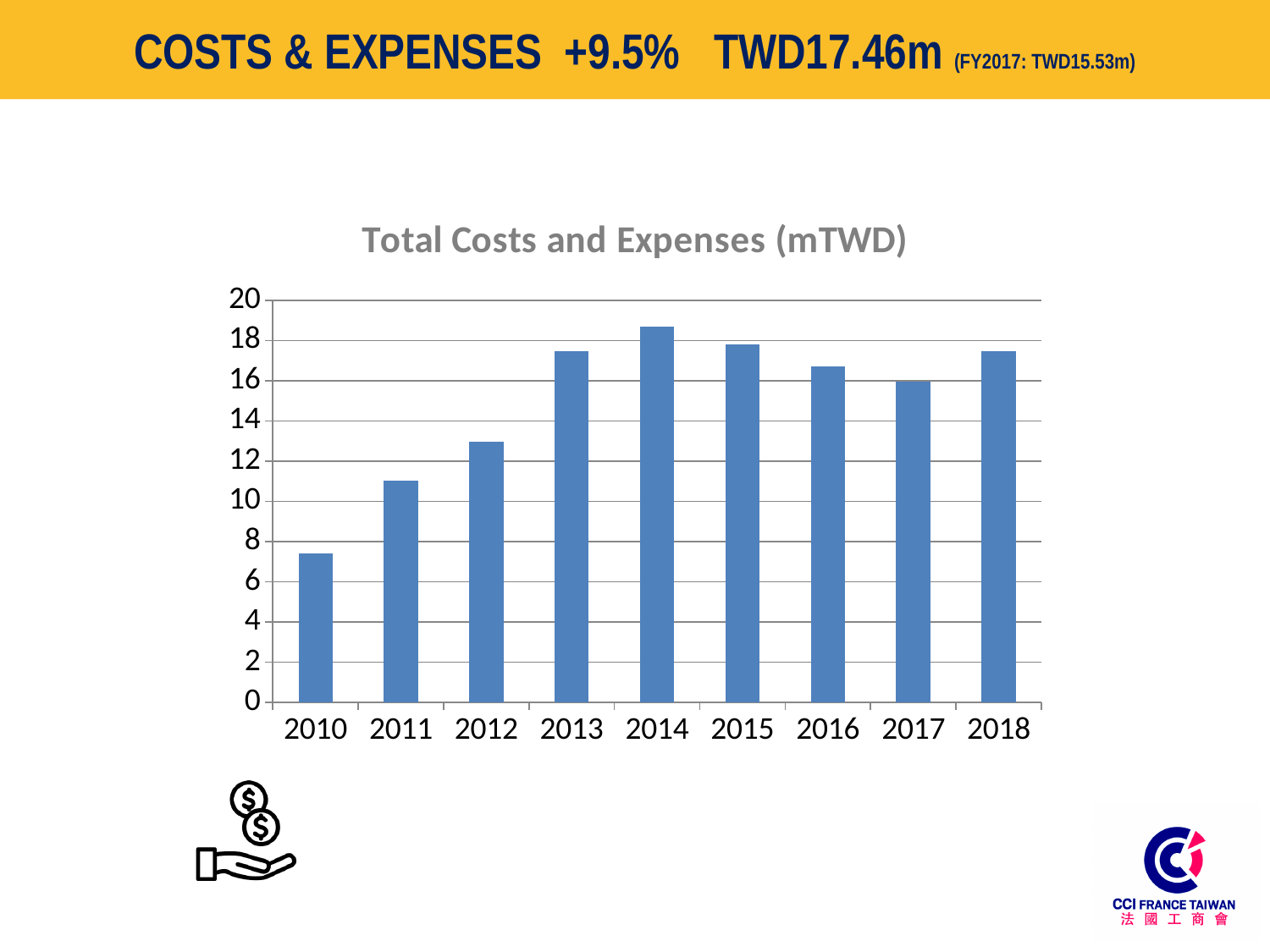
How many years are plotted on the x axis of the chart? 9 Which year has the highest total costs and expenses? 2014 Which year has the larger value, 2016 or 2017? 2016 Is the value for 2014 greater or less than 18? greater Is the value for 2011 greater or less than 10? greater Which year has the lowest total costs and expenses? 2010 Is the value for 2010 greater or less than 8? less What kind of chart is shown on the slide? bar chart What is the title of the chart? Total Costs and Expenses (mTWD) Which year has the larger value, 2014 or 2015? 2014 Do the values rise or fall from 2010 to 2014? rise